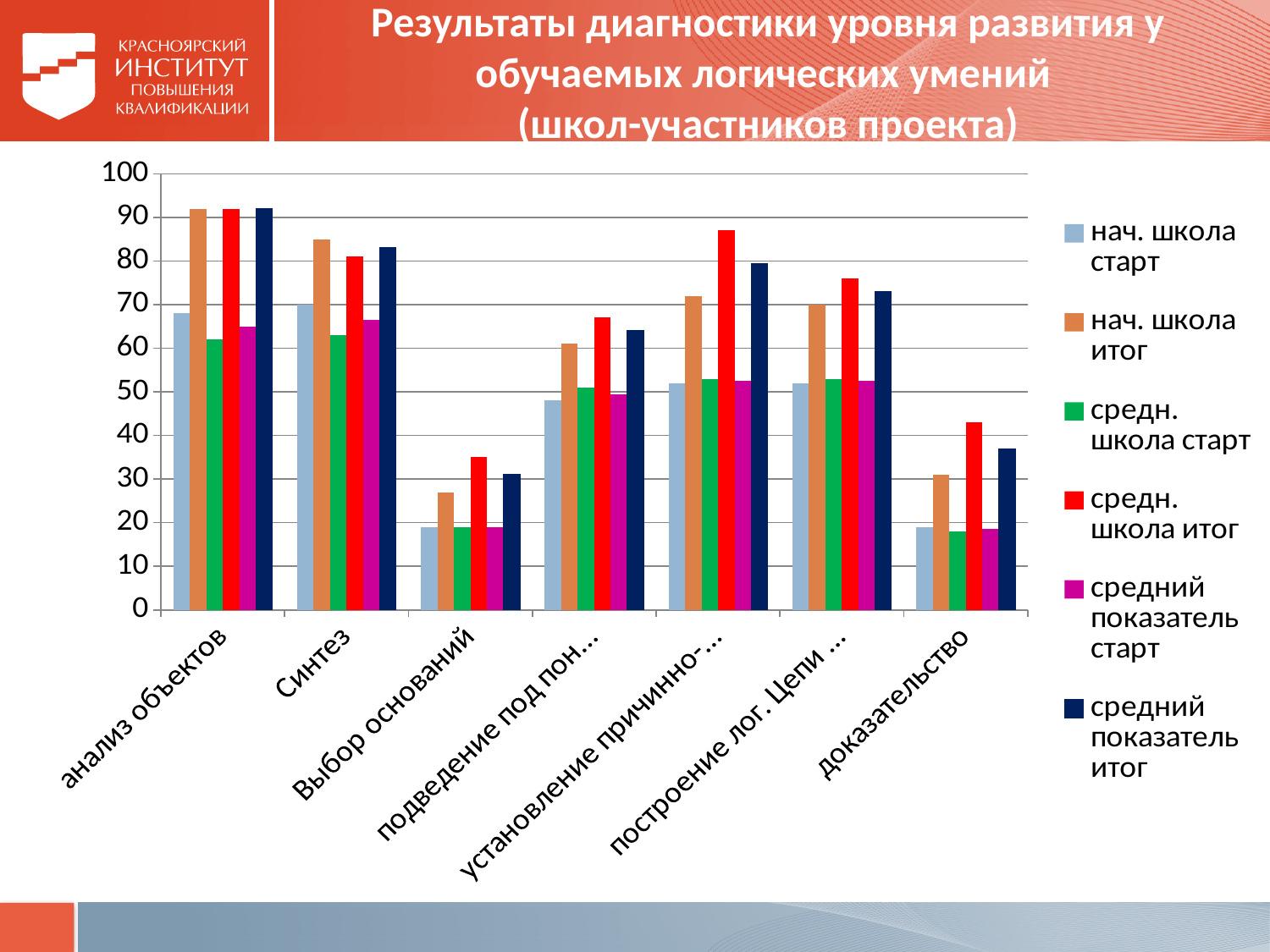
Is the value of "средн. школа итог" for "доказательство" greater or less than 50? less Is the value of "средн. школа старт" for "Синтез" greater or less than 60? greater Is the value of "средн. школа итог" for "Выбор оснований" greater or less than 30? greater Which category has the highest value for "средн. школа итог"? анализ объектов What kind of chart is shown on the slide? bar chart Which category has the lowest value for "нач. школа итог"? Выбор оснований How many series does the legend list? 6 Which colour represents "средн. школа итог" in the legend? red For "Выбор оснований", which is larger: "нач. школа итог" or "средн. школа итог"? средн. школа итог How many categories are shown along the x axis? 7